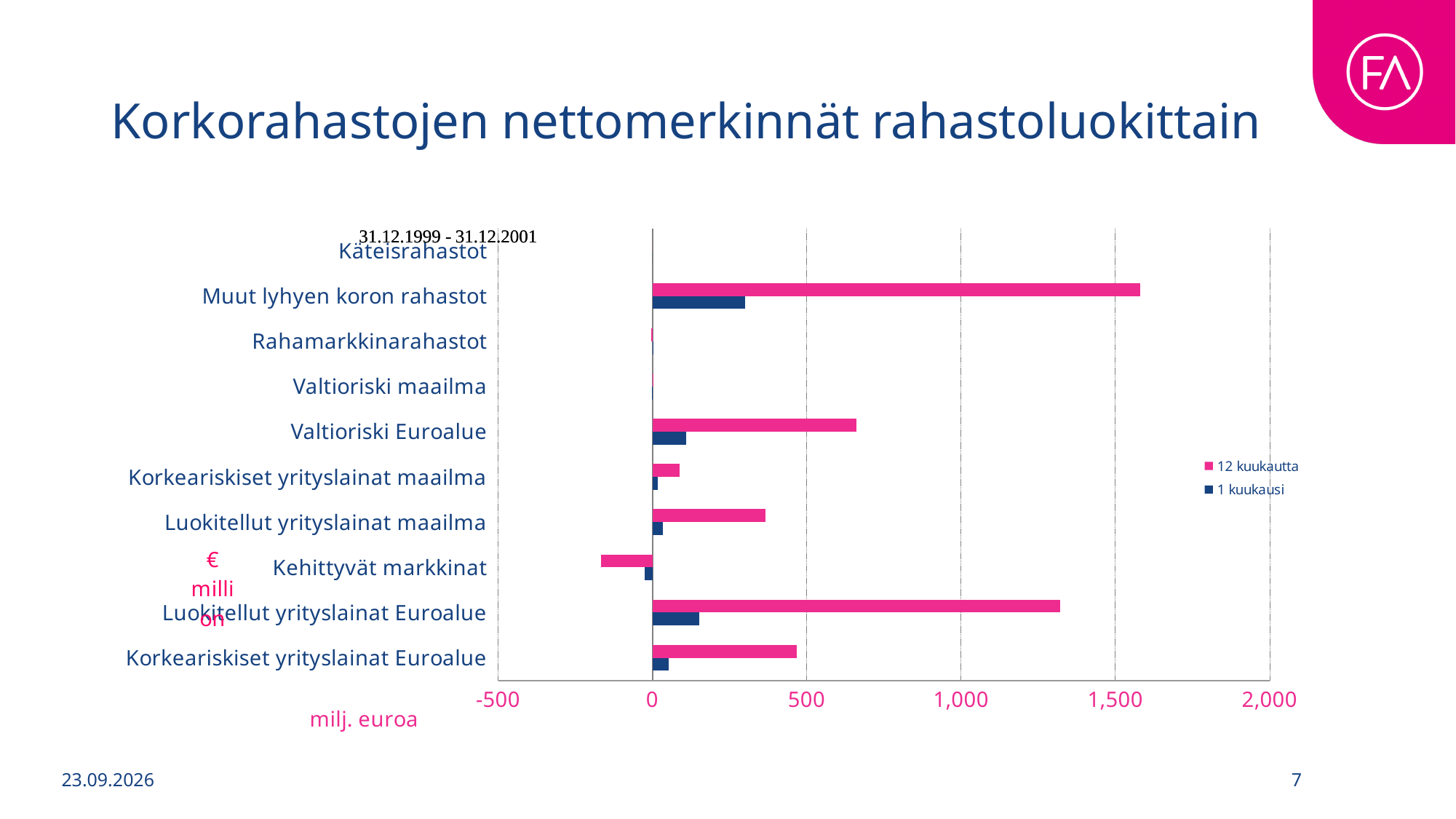
How many series does the chart's legend list? 2 Which category has the highest value for the 1 kuukausi series? Muut lyhyen koron rahastot Which category has the highest value for the 12 kuukautta series? Muut lyhyen koron rahastot For the 12 kuukautta series, which is larger: Valtioriski Euroalue or Luokitellut yrityslainat maailma? Valtioriski Euroalue Is the 12 kuukautta value for Muut lyhyen koron rahastot greater or less than 1,000? greater Is the 12 kuukautta value for Kehittyvät markkinat greater or less than 0? less Is the 12 kuukautta value for Valtioriski Euroalue greater or less than 500? greater Which category has the lowest value for the 12 kuukautta series? Kehittyvät markkinat What kind of chart is shown on the slide? Bar chart How many fund categories are listed on the chart's vertical axis? 10 What unit label is shown below the chart's horizontal axis? milj. euroa